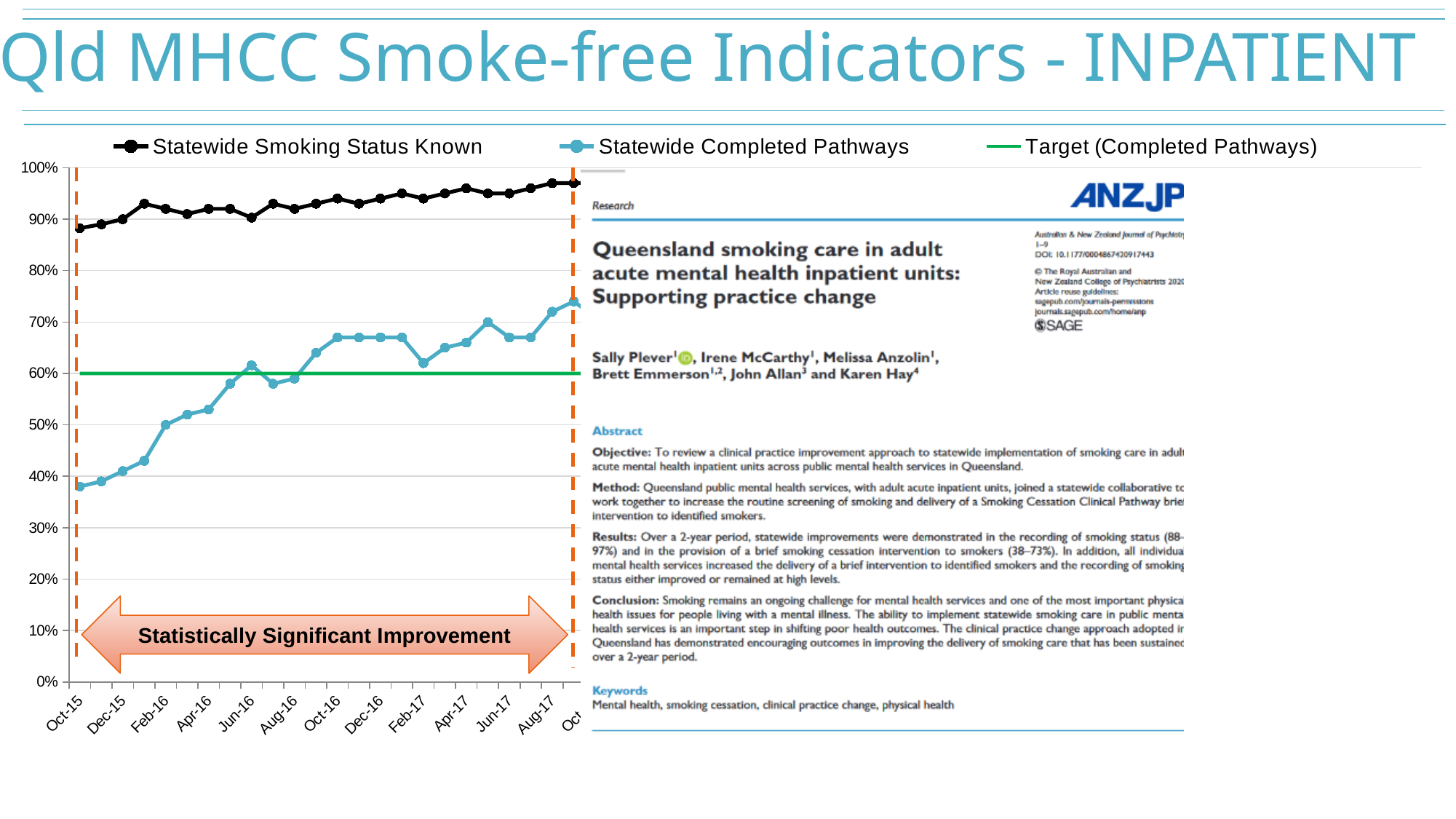
Does the Statewide Completed Pathways series generally rise or fall from Oct-15 to Aug-17? rise At Oct-15, which series has the higher value: Statewide Smoking Status Known or Statewide Completed Pathways? Statewide Smoking Status Known Is the value for Statewide Completed Pathways at Aug-17 greater or less than 70%? greater How many series does the chart legend list? 3 What kind of chart is shown on the slide? line chart Is the value for Statewide Completed Pathways at Oct-15 greater or less than 40%? less Is the value for Statewide Completed Pathways at Apr-16 greater or less than 60%? less What value is the Target (Completed Pathways) line set at? 60% What colour is the Target (Completed Pathways) line in the chart? green Is the value for Statewide Completed Pathways larger at Oct-15 or at Oct-16? Oct-16